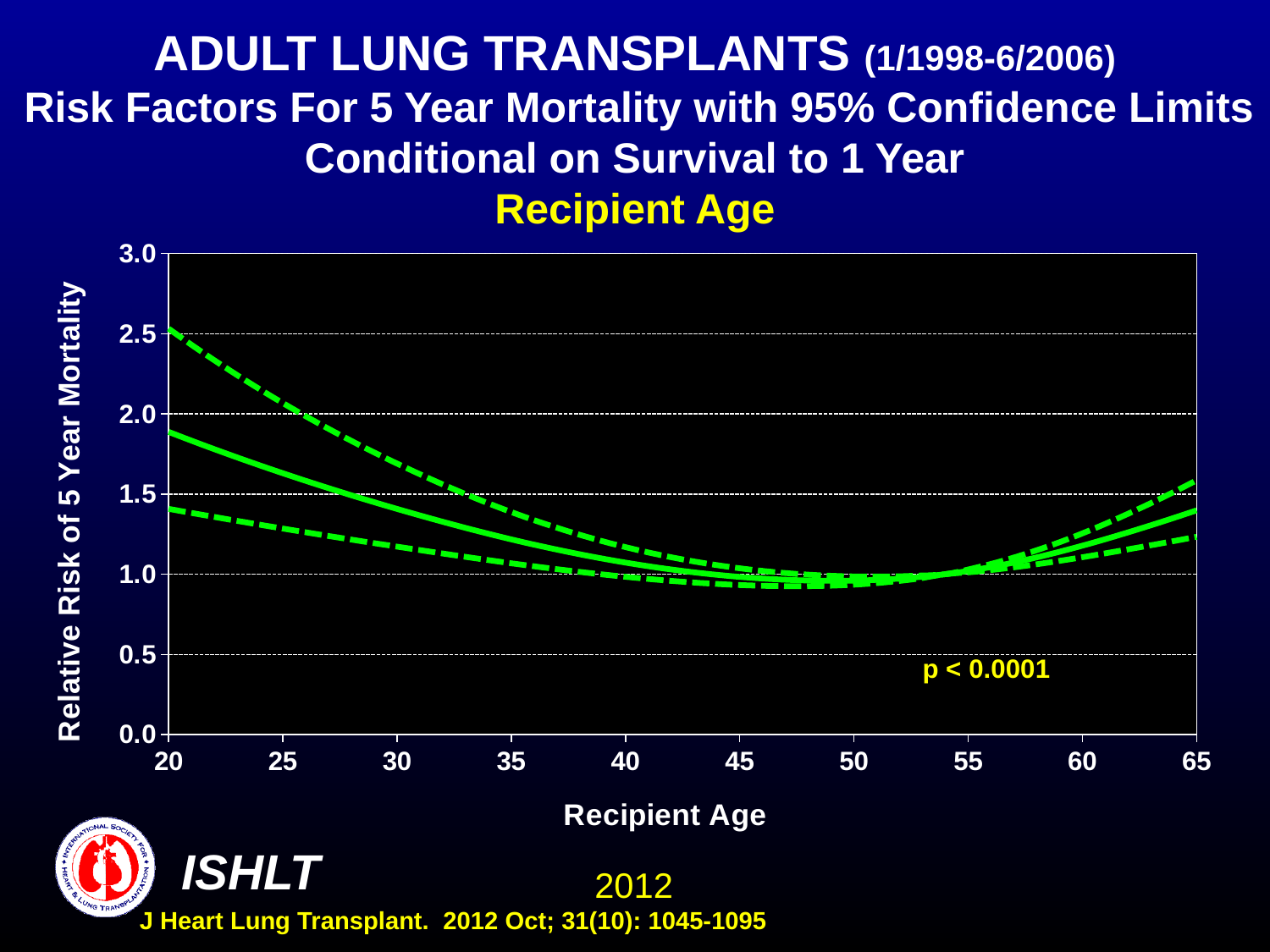
What is the label of the y axis? Relative Risk of 5 Year Mortality How many lines are plotted on the chart? 3 Is the relative risk on the solid line at recipient age 20 greater or less than 1.5? greater What is the highest value shown on the y axis? 3.0 What is the label of the x axis? Recipient Age Does the solid line rise or fall as recipient age increases from 20 to 50? fall Is the relative risk on the upper dashed line at recipient age 20 greater or less than 2.0? greater Is the relative risk on the solid line at recipient age 20 greater or less than 2.0? less What p-value is printed on the chart? p < 0.0001 What kind of chart is shown on the slide? line chart Does the solid line rise or fall as recipient age increases from 55 to 65? rise